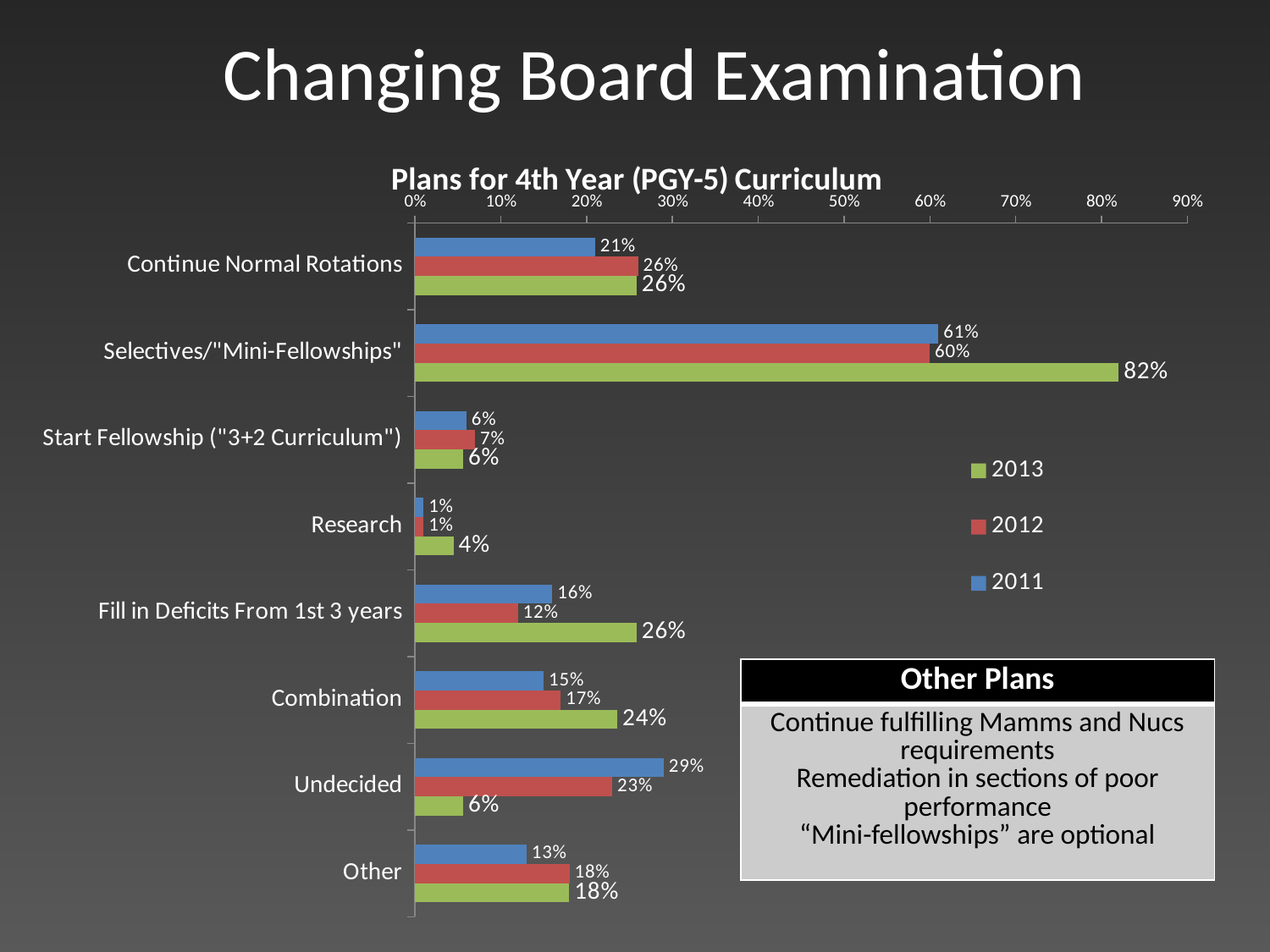
How many categories are shown on the chart? 8 What is the 2013 value for Selectives/"Mini-Fellowships"? 82% What kind of chart is shown on the slide? Bar chart What is the title of the chart? Plans for 4th Year (PGY-5) Curriculum Which category has the highest 2013 value? Selectives/"Mini-Fellowships" What is the 2011 value for Undecided? 29% Which category has the lowest 2011 value? Research What is the 2012 value for Fill in Deficits From 1st 3 years? 12% Which colour represents the 2012 series in the legend? Red How many series does the legend list? 3 For Undecided, which series has the larger value, 2011 or 2013? 2011 What is the difference between the 2013 and 2011 values for Selectives/"Mini-Fellowships"? 21%